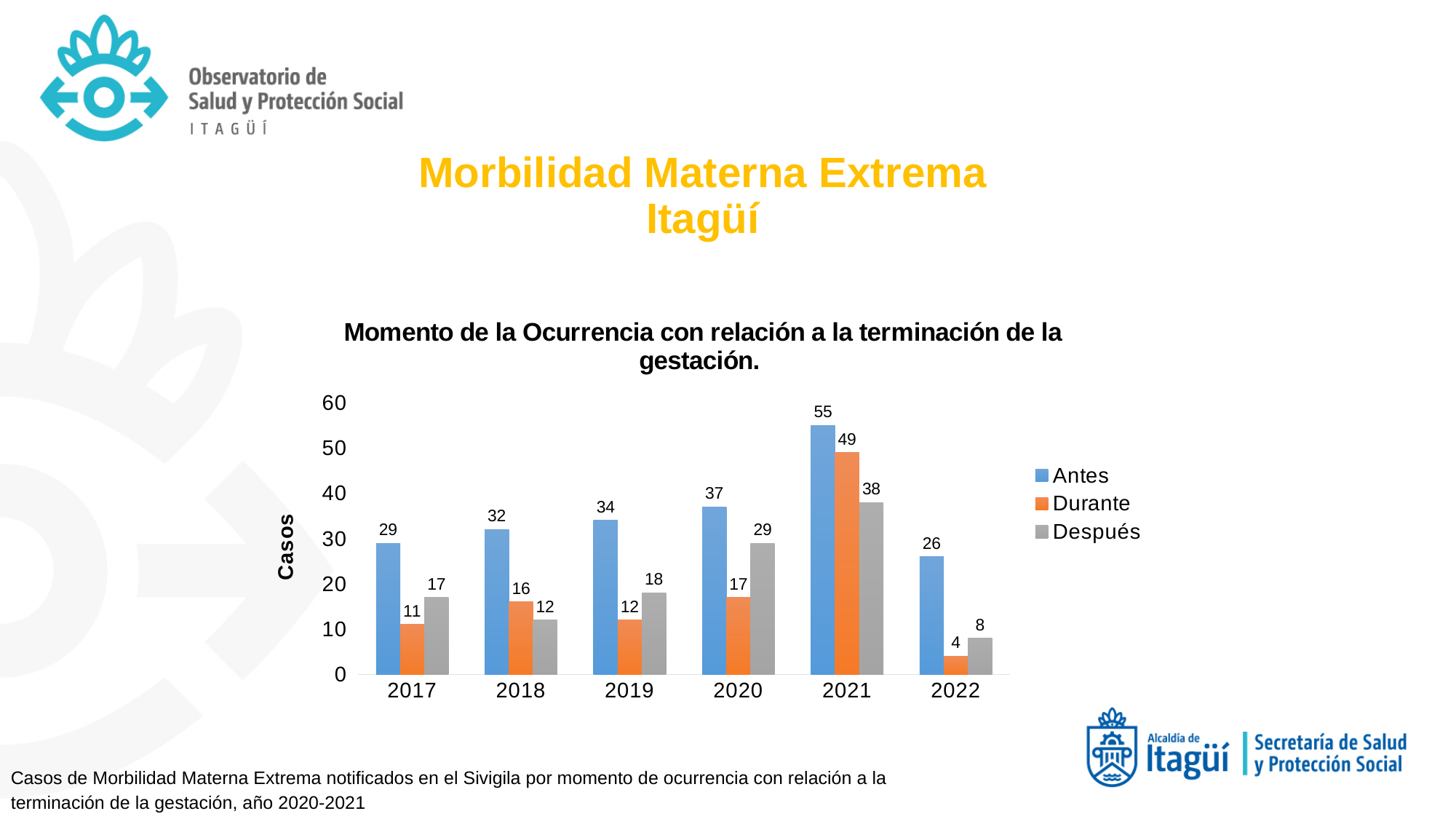
Does the value for Antes rise or fall from 2017 to 2021? Rise What is the value for Durante in 2022? 4 What kind of chart is shown? Bar chart What is the value for Antes in 2021? 55 Which year has the lowest value for Después? 2022 Which is larger in 2017, Durante or Después? Después What is the difference between Antes and Durante in 2020? 20 How many years are shown on the x axis? 6 Which year has the highest value for Durante? 2021 How many series does the legend list? 3 What is the label on the y axis? Casos What is the value for Después in 2019? 18